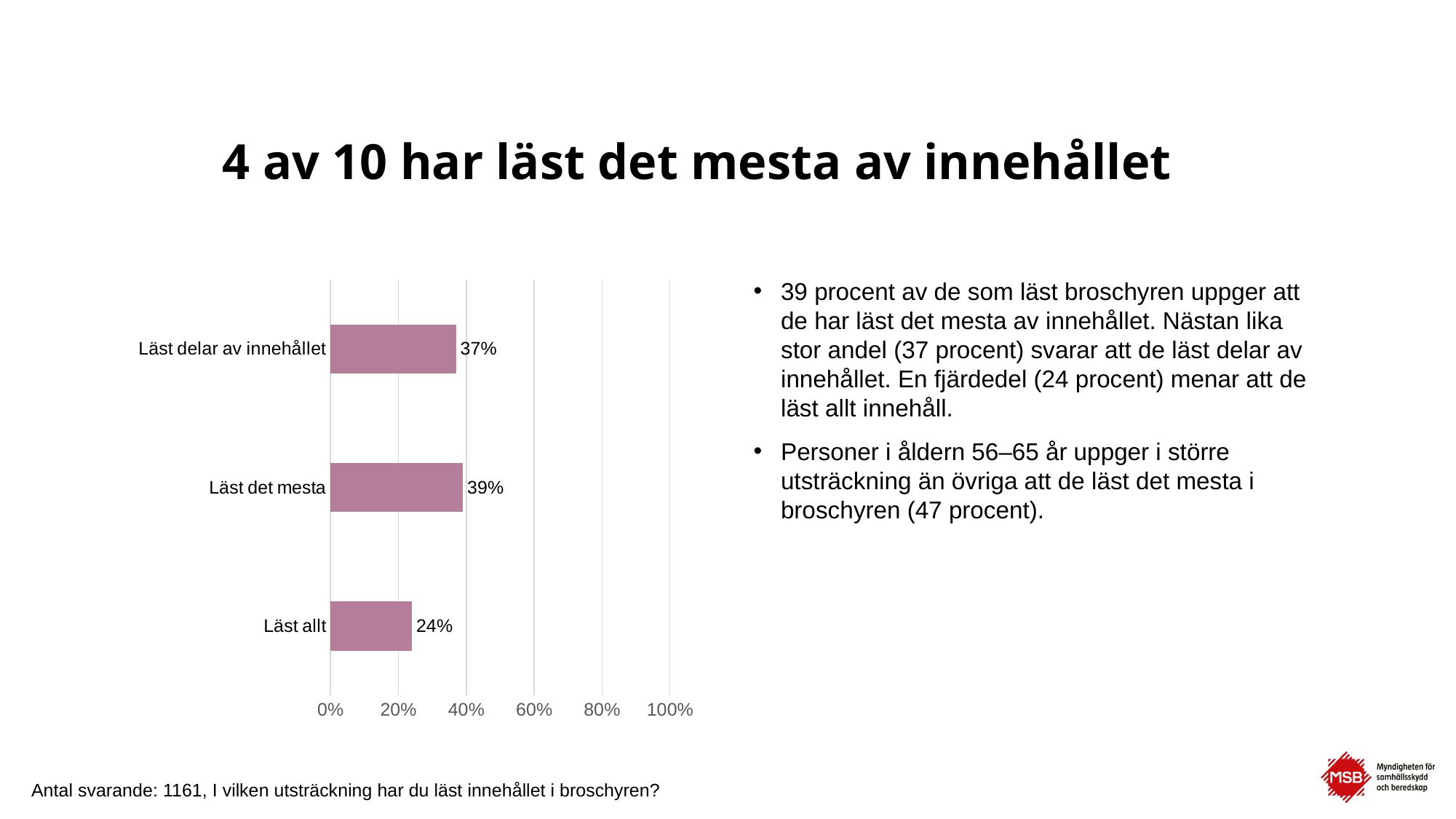
What is the value for "Läst allt"? 24% Which is larger, the value for "Läst delar av innehållet" or the value for "Läst allt"? Läst delar av innehållet What is the difference between the values for "Läst det mesta" and "Läst allt"? 15% How many categories are shown in the chart? 3 What is the value for "Läst delar av innehållet"? 37% What is the difference between the values for "Läst delar av innehållet" and "Läst allt"? 13% What is the highest value shown on the chart's axis? 100% Which category has the lowest value? Läst allt What kind of chart is shown on the slide? bar chart Is the value for "Läst allt" greater or less than 40%? less What is the value for "Läst det mesta"? 39% Which category has the highest value? Läst det mesta